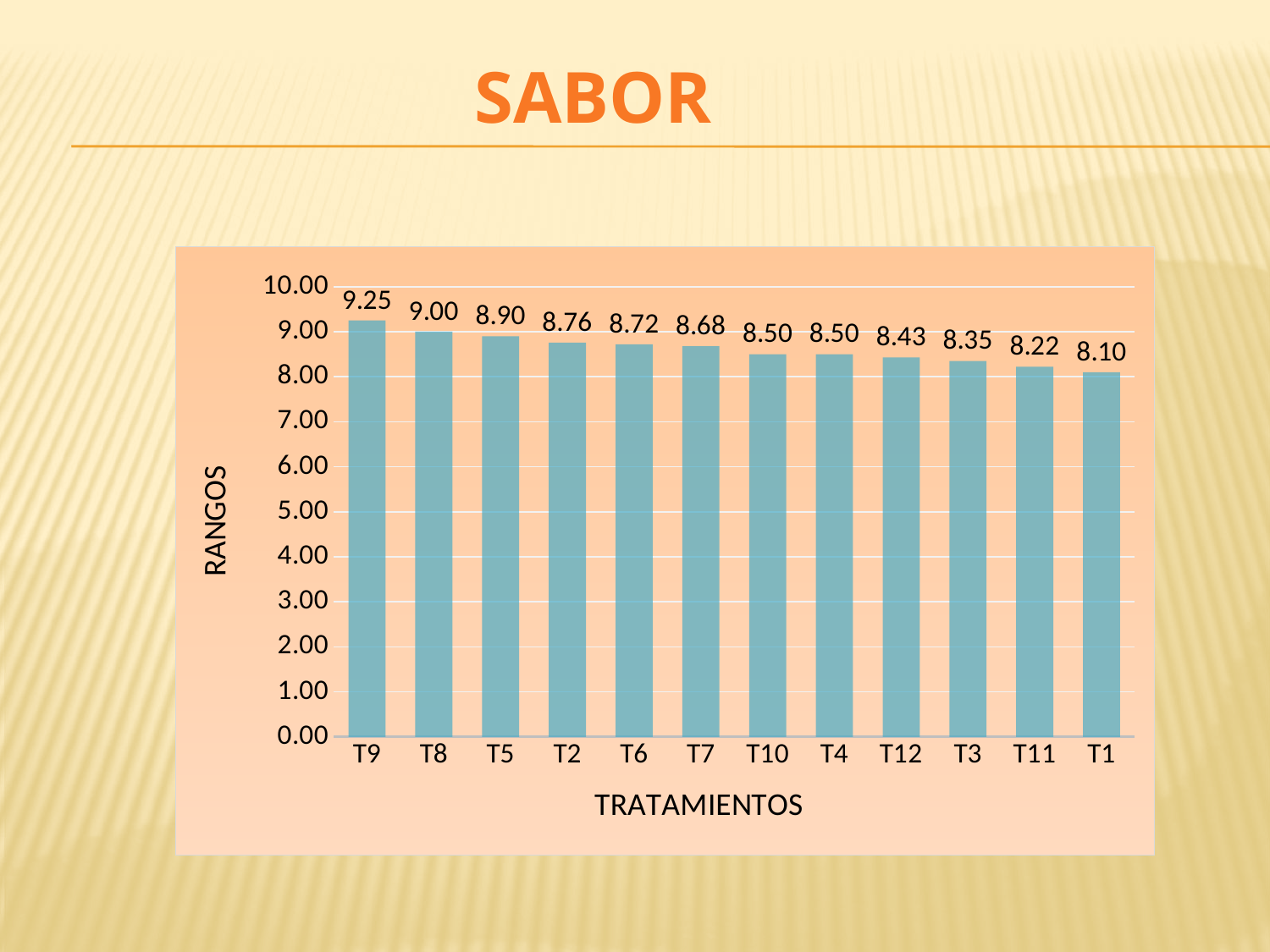
What is the difference between the values for T9 and T1? 1.15 Do the values rise or fall from left to right along the x axis? fall What is the value for T9? 9.25 Which treatment has the lowest value? T1 What is the value for T1? 8.10 Which is larger, the value for T2 or the value for T3? T2 What is the value for T12? 8.43 What is the difference between the values for T8 and T5? 0.10 Is the value for T11 greater or less than 9.00? less Which treatment has the highest value? T9 How many treatments are shown on the x axis? 12 What kind of chart is shown on the slide? bar chart